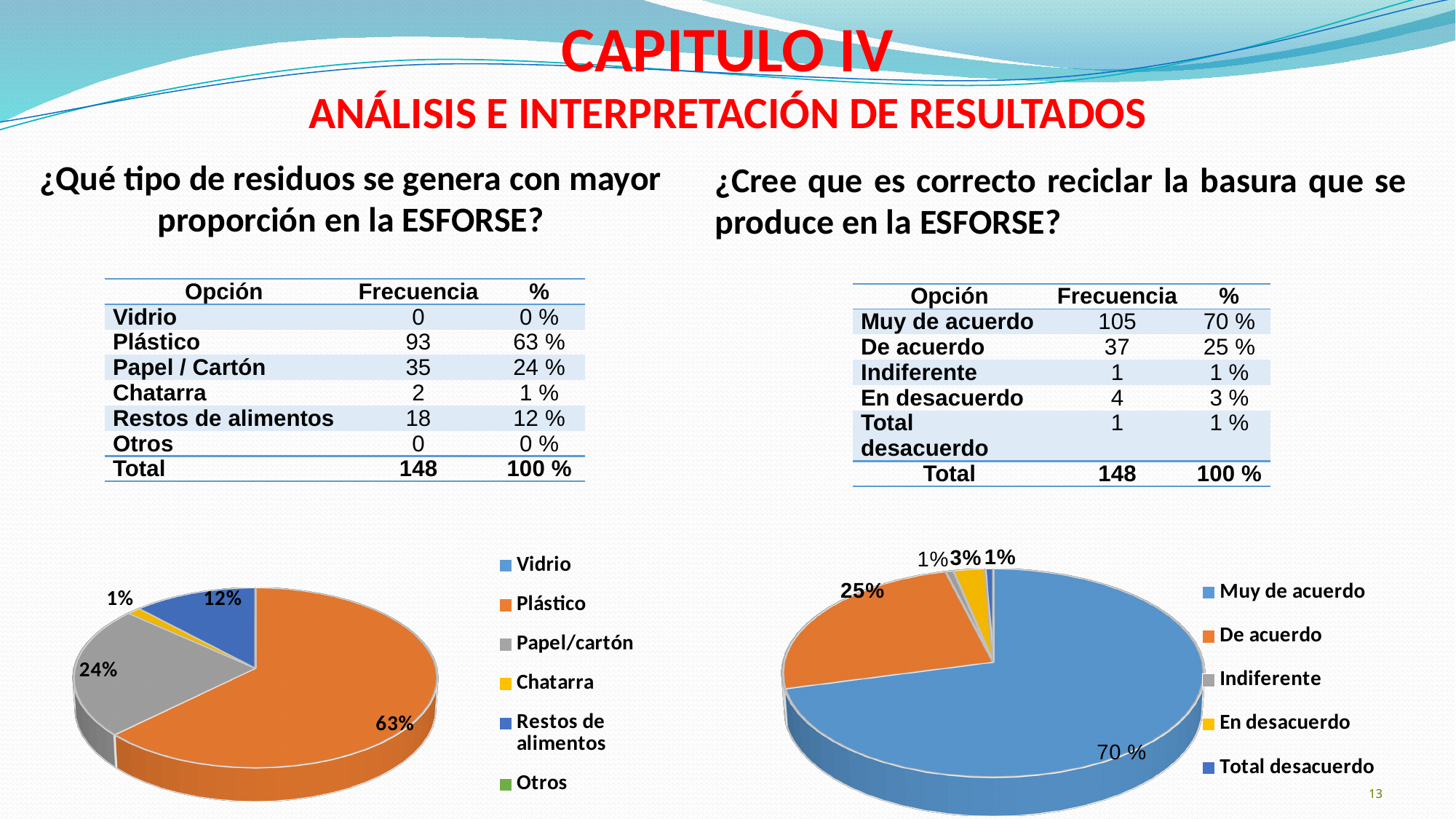
In the right pie chart (recycling opinion), how many entries does the legend list? 5 In the right pie chart (recycling opinion), what share is labelled for De acuerdo? 25% In the right pie chart (recycling opinion), what share is labelled for En desacuerdo? 3% In the left pie chart (waste types), what is the difference between the Plástico and Papel/cartón shares? 39% In the right pie chart (recycling opinion), which category has the largest slice? Muy de acuerdo In the left pie chart (waste types), what share is labelled for Restos de alimentos? 12% In the left pie chart (waste types), which category has the largest slice? Plástico In the left pie chart (waste types), how many entries does the legend list? 6 In the left pie chart (waste types), what share is labelled for Plástico? 63% What type of chart is used on the right side of the slide (recycling opinion)? Pie chart In the left pie chart (waste types), what share is labelled for Papel/cartón? 24% In the right pie chart (recycling opinion), what share is labelled for Muy de acuerdo? 70 %